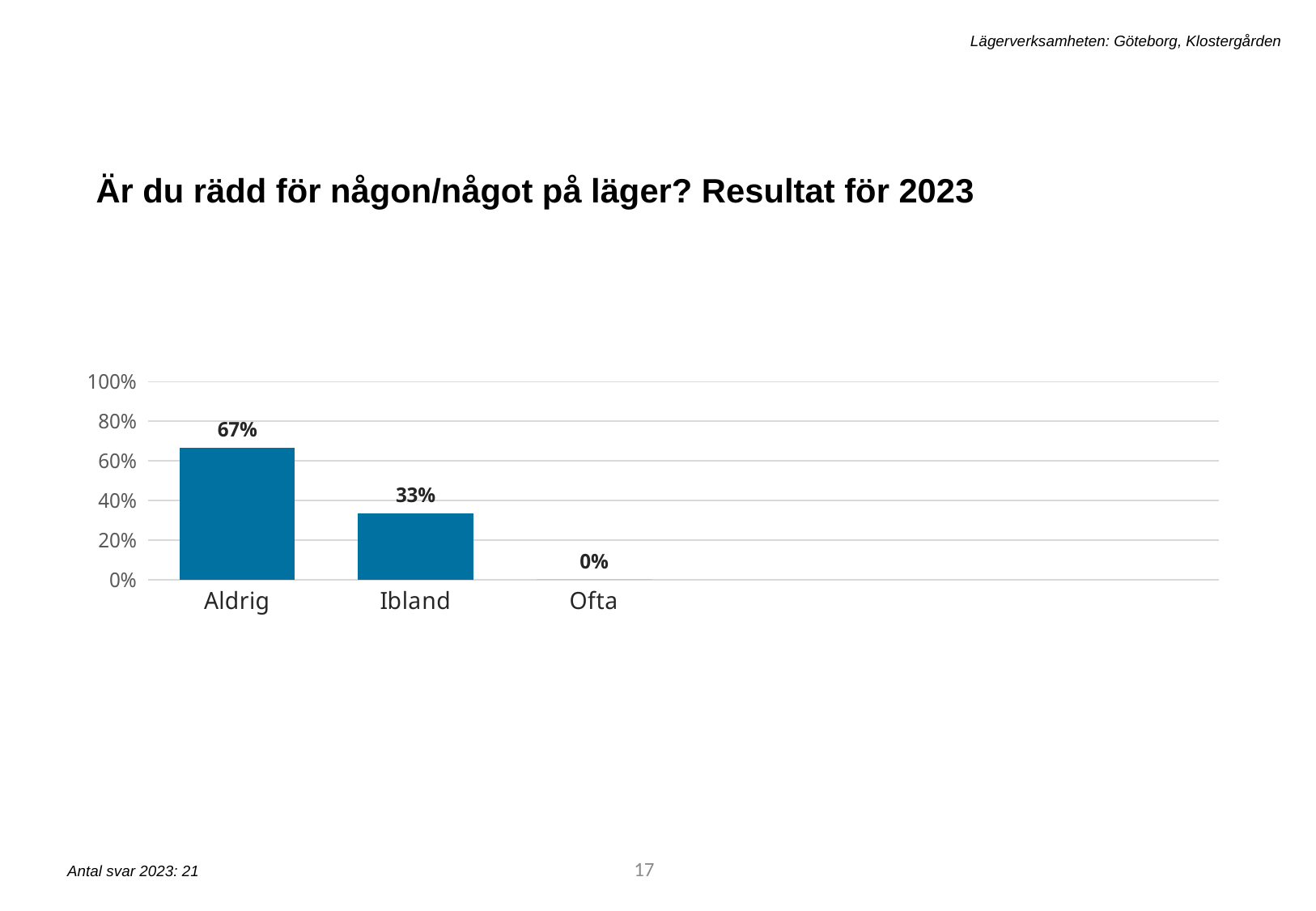
Which category has the highest value? Aldrig Do the values rise or fall from left to right along the x axis? fall What is the value for Ibland? 33% What is the title of the slide above the chart? Är du rädd för någon/något på läger? Resultat för 2023 Is the value for Aldrig greater or less than 60%? greater What is the value for Ofta? 0% Which is larger, the value for Ibland or the value for Ofta? Ibland What is the value for Aldrig? 67% What kind of chart is shown on the slide? bar chart What is the difference between the values for Aldrig and Ibland? 34% How many categories are shown on the x axis? 3 Which category has the lowest value? Ofta